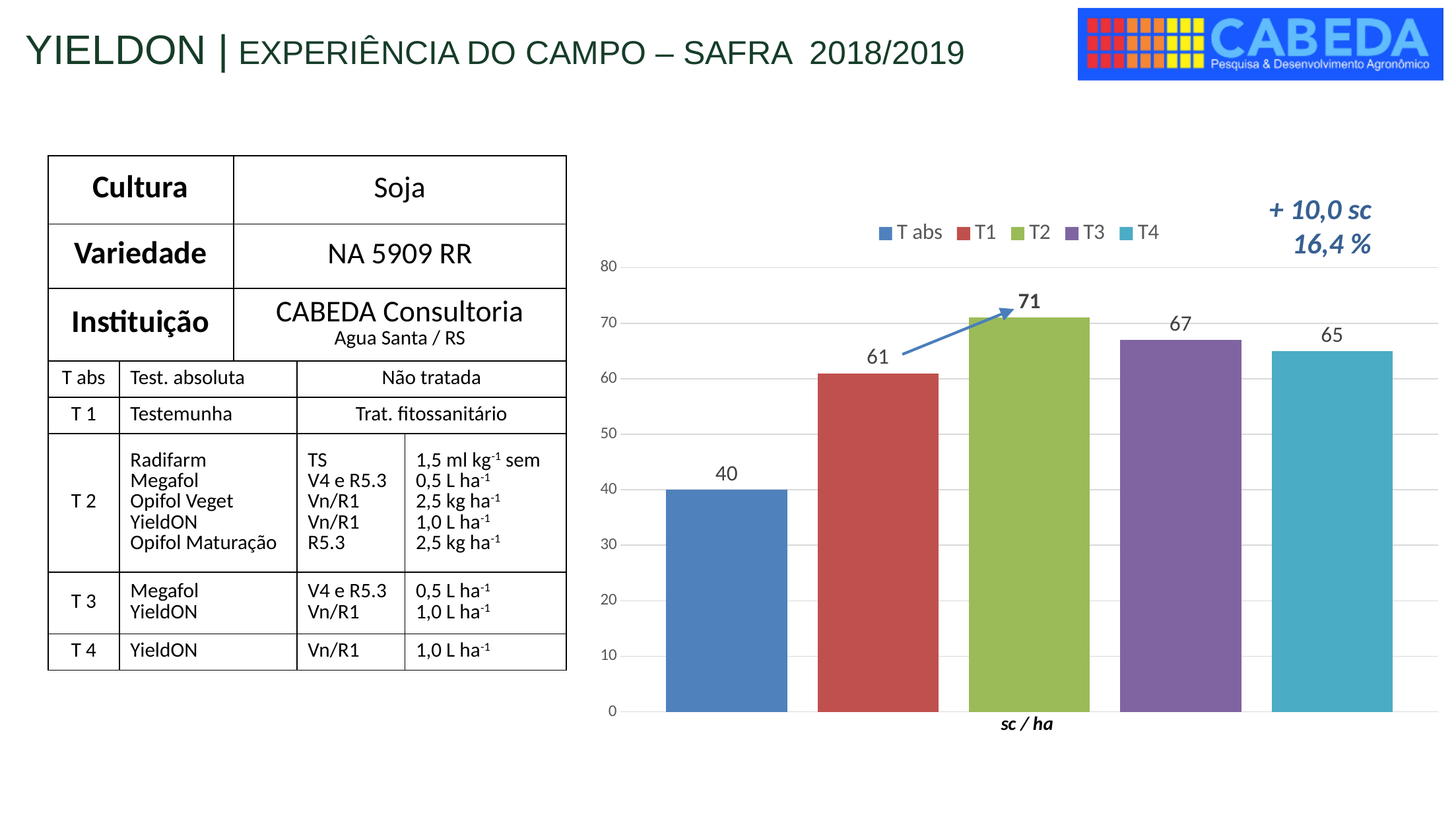
What is the difference between the values for T2 and T1? 10 What unit label is shown below the x axis of the chart? sc / ha What is the value for T4 in the chart? 65 How many bars are plotted in the chart? 5 Which is larger, the value for T1 or the value for T3? T3 What is the difference between the values for T3 and T abs? 27 What kind of chart is shown on the slide? Bar chart How many series does the legend list? 5 Which series has the highest value in the chart? T2 What is the value for T2 in the chart? 71 What is the value for T abs in the chart? 40 Which series has the lowest value in the chart? T abs